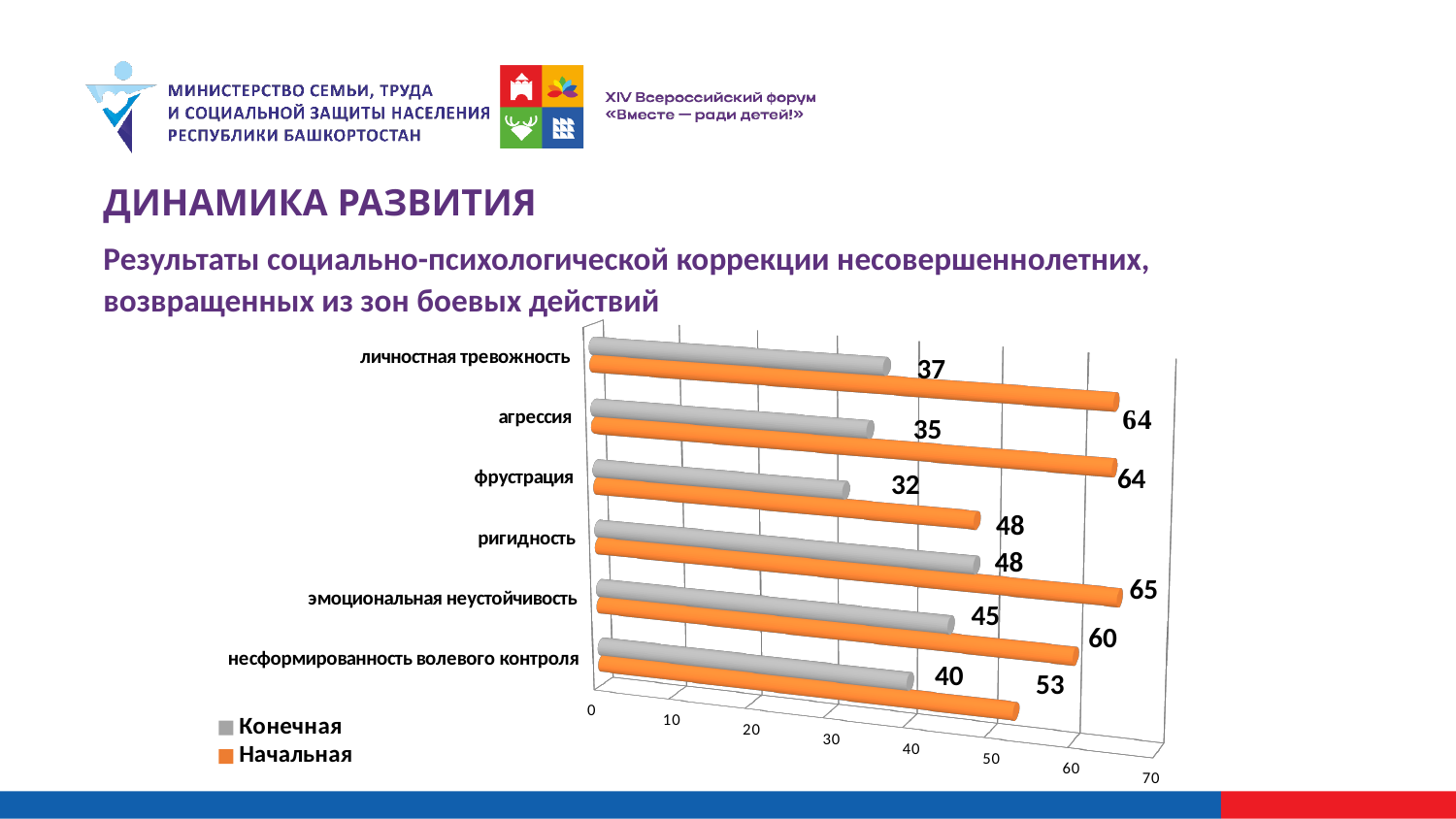
Which colour represents the Начальная series? orange Which category has the lowest Конечная value? фрустрация How many categories are shown on the chart? 6 What kind of chart is shown on the slide? bar chart Which category has the highest Начальная value? ригидность Which is larger for ригидность: the Начальная value or the Конечная value? Начальная What is the Начальная value for фрустрация? 48 What is the difference between the Начальная and Конечная values for эмоциональная неустойчивость? 15 What is the Конечная value for несформированность волевого контроля? 40 How many series does the legend list? 2 What is the Начальная value for личностная тревожность? 64 What is the Конечная value for агрессия? 35